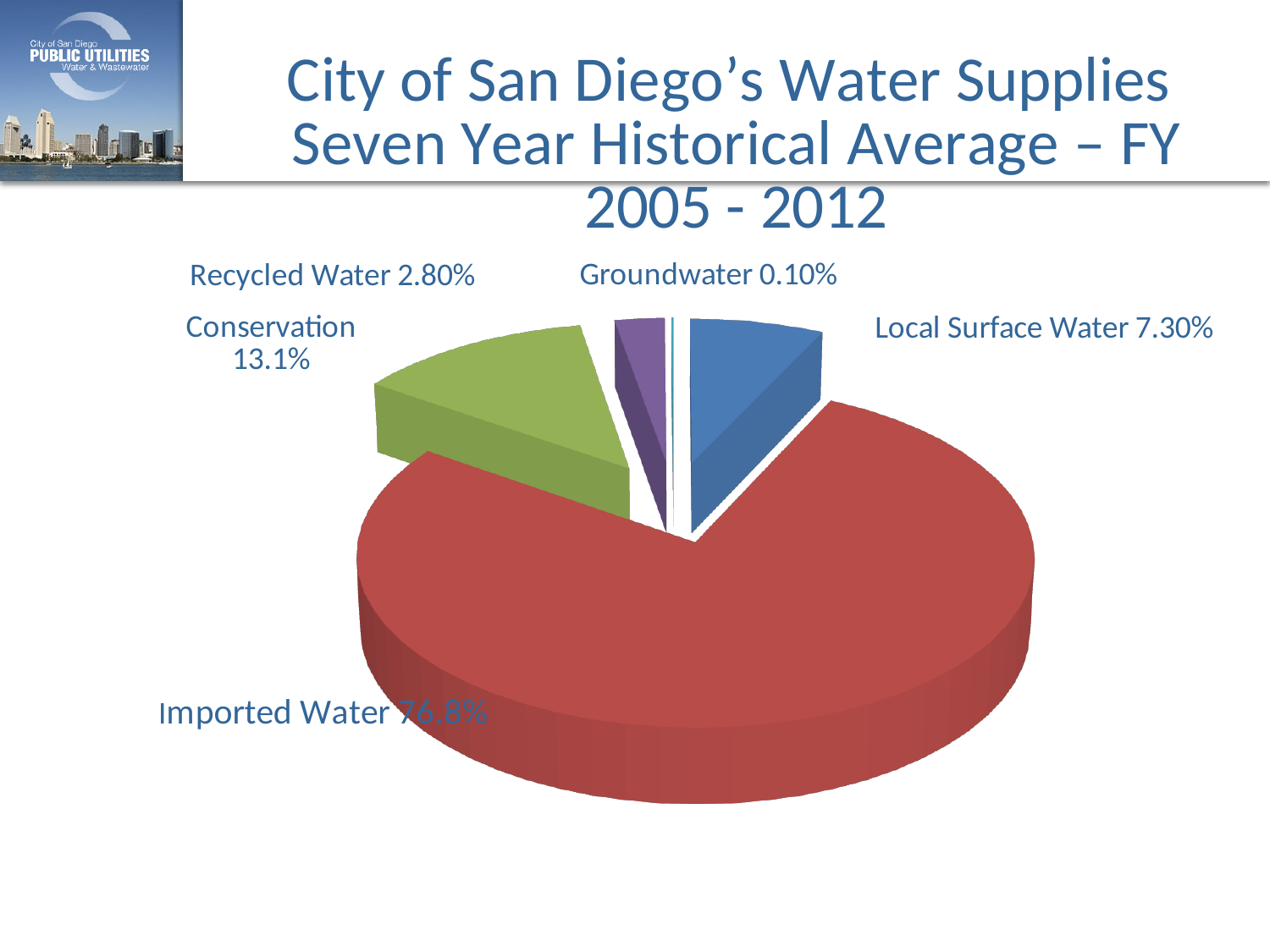
What kind of chart is shown on the slide? Pie chart What is the difference in percentage points between Imported Water and Conservation? 63.7 What percentage is shown for Groundwater? 0.10% What percentage is shown for Recycled Water? 2.80% Which is larger, the share for Conservation or the share for Local Surface Water? Conservation What colour is the Imported Water slice? Red What share of the City of San Diego's water supplies is Imported Water? 76.8% What percentage is shown for Conservation? 13.1% Which water supply source has the largest share of the pie? Imported Water Which water supply source has the smallest share of the pie? Groundwater What percentage is shown for Local Surface Water? 7.30% How many slices does the pie chart have? 5